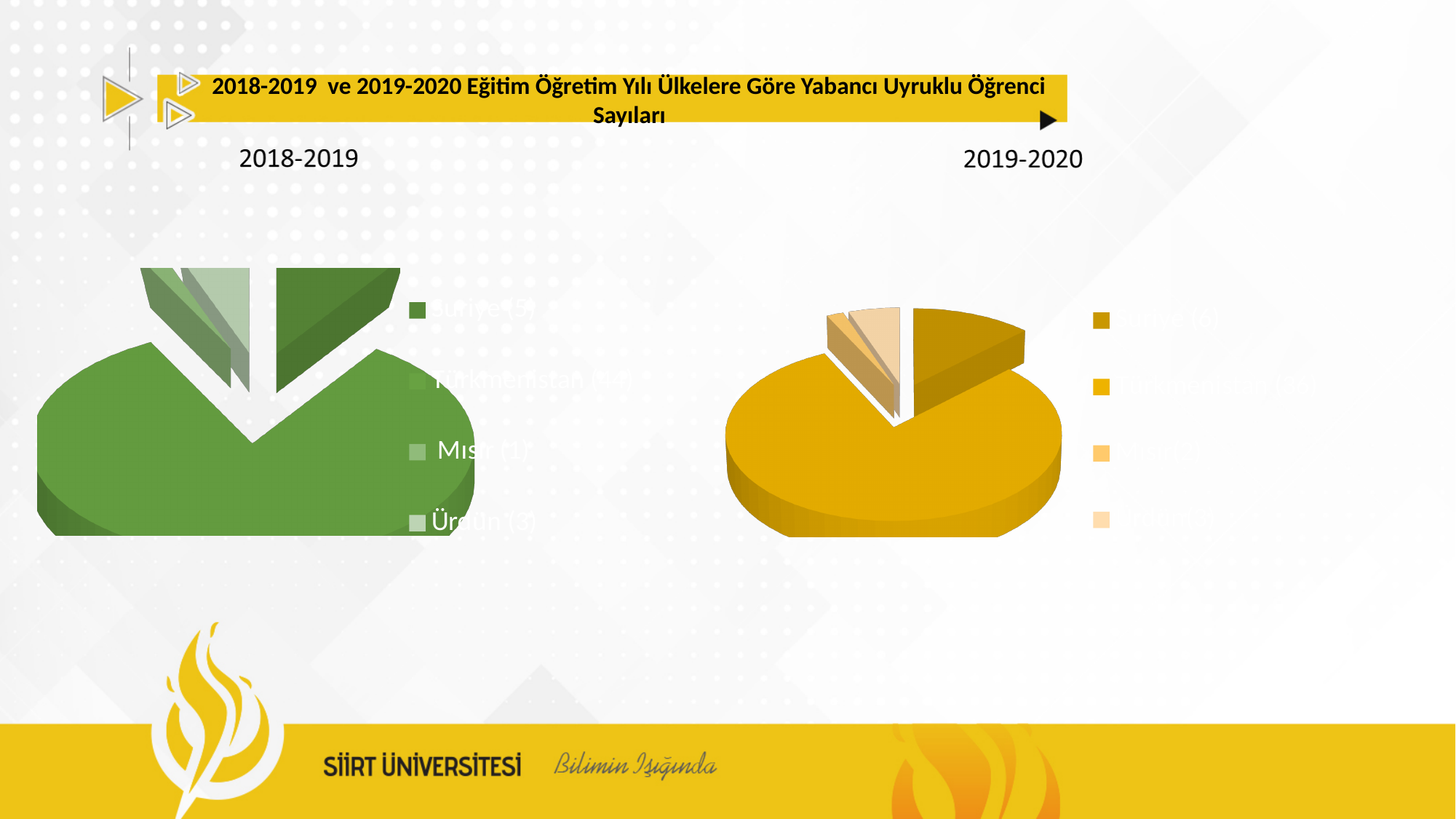
In the 2018-2019 chart, how many countries are listed in the legend? 4 In the 2019-2020 chart, which country has the largest slice? Türkmenistan In the 2018-2019 chart, which has more students, Suriye or Ürdün? Suriye In the 2018-2019 chart, how many students are from Mısır? 1 In the 2018-2019 chart, what is the difference between the number of students from Suriye and from Ürdün? 2 In the 2018-2019 chart, how many students are from Suriye? 5 Which academic year does the chart on the right side of the slide show? 2019-2020 In the 2019-2020 chart, how many countries are listed in the legend? 4 In the 2018-2019 chart, which country has the largest slice? Türkmenistan In the 2018-2019 chart, how many students are from Ürdün? 3 What kind of chart is used for the 2018-2019 data? Pie chart In the 2018-2019 chart, which country has the smallest slice? Mısır